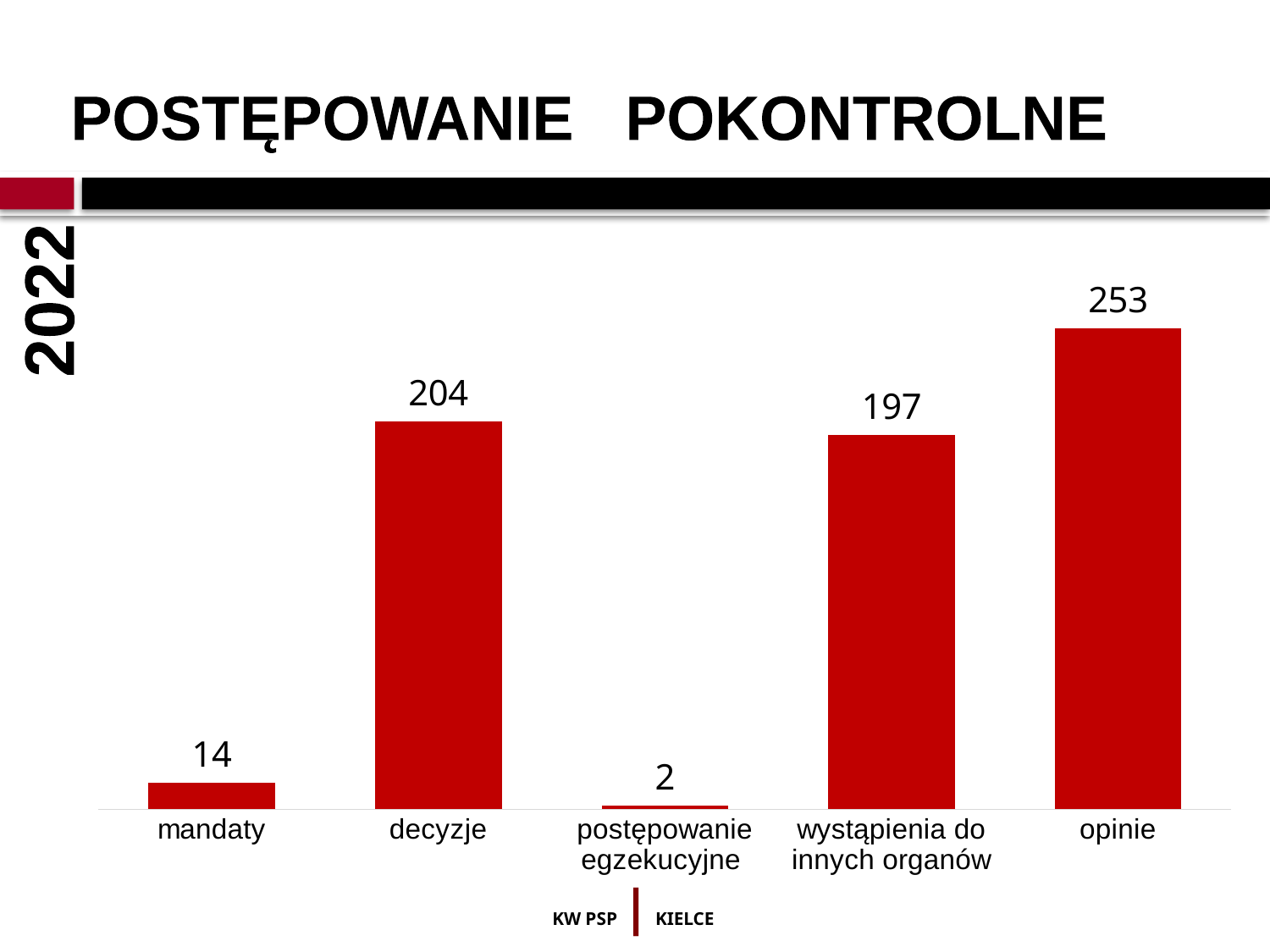
What year is shown on the slide next to the chart? 2022 What kind of chart is shown on the slide? bar chart What is the value for wystąpienia do innych organów? 197 What is the value for decyzje? 204 What is the value for postępowanie egzekucyjne? 2 Which is larger, the value for decyzje or the value for wystąpienia do innych organów? decyzje How many categories are shown on the chart? 5 What is the value for opinie? 253 Which category has the highest value? opinie Which category has the lowest value? postępowanie egzekucyjne What is the difference between the values for opinie and decyzje? 49 What is the value for mandaty? 14